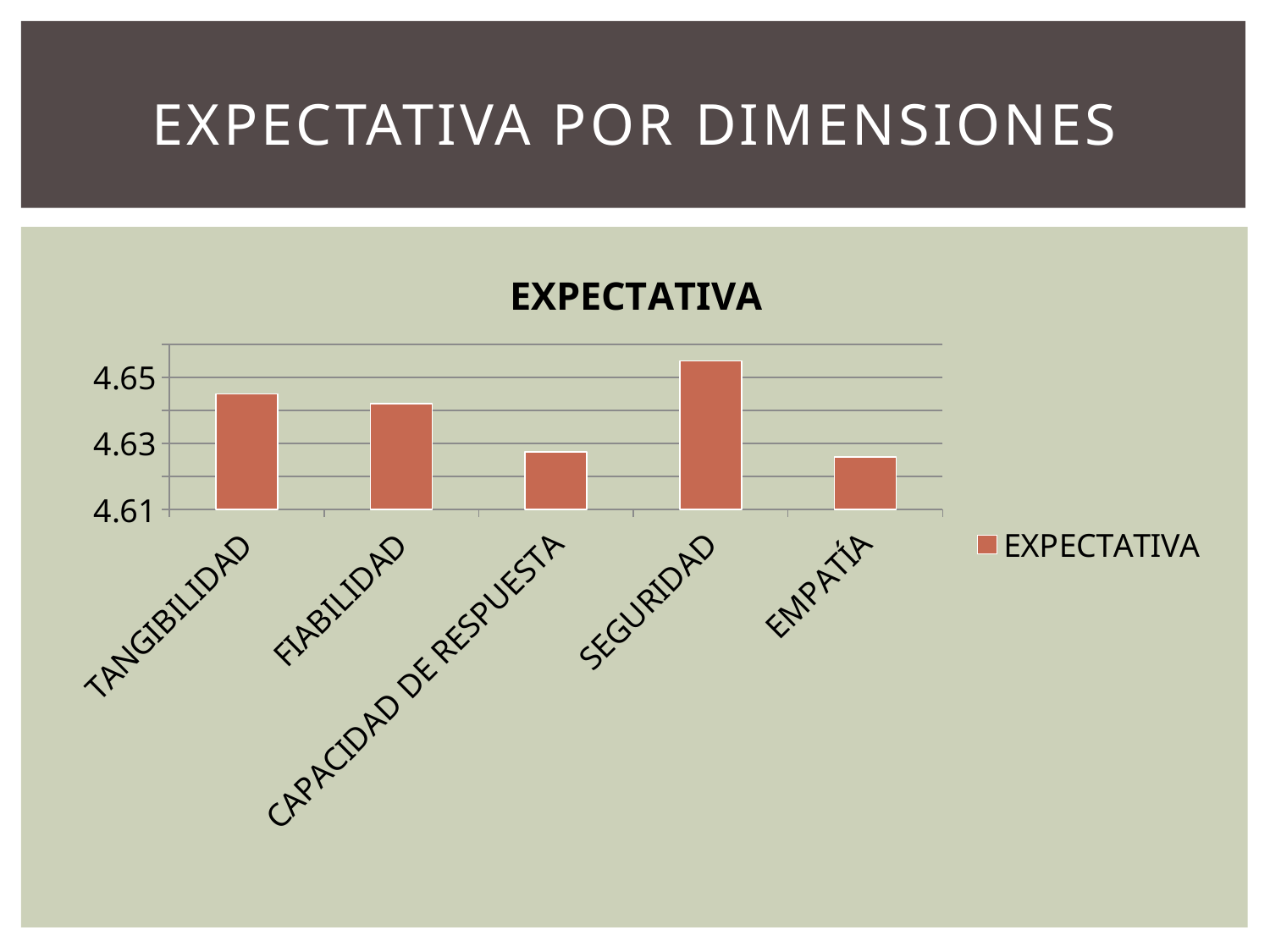
Is the value for CAPACIDAD DE RESPUESTA greater or less than 4.63? less Which is larger, the value for SEGURIDAD or the value for TANGIBILIDAD? SEGURIDAD Which category has the highest value in the EXPECTATIVA chart? SEGURIDAD How many series does the legend of the chart list? 1 Which is larger, the value for TANGIBILIDAD or the value for EMPATÍA? TANGIBILIDAD What is the title of the chart? EXPECTATIVA Is the value for TANGIBILIDAD greater or less than 4.65? less Is the value for SEGURIDAD greater or less than 4.65? greater How many categories are plotted in the EXPECTATIVA chart? 5 What kind of chart is shown on the slide? bar chart